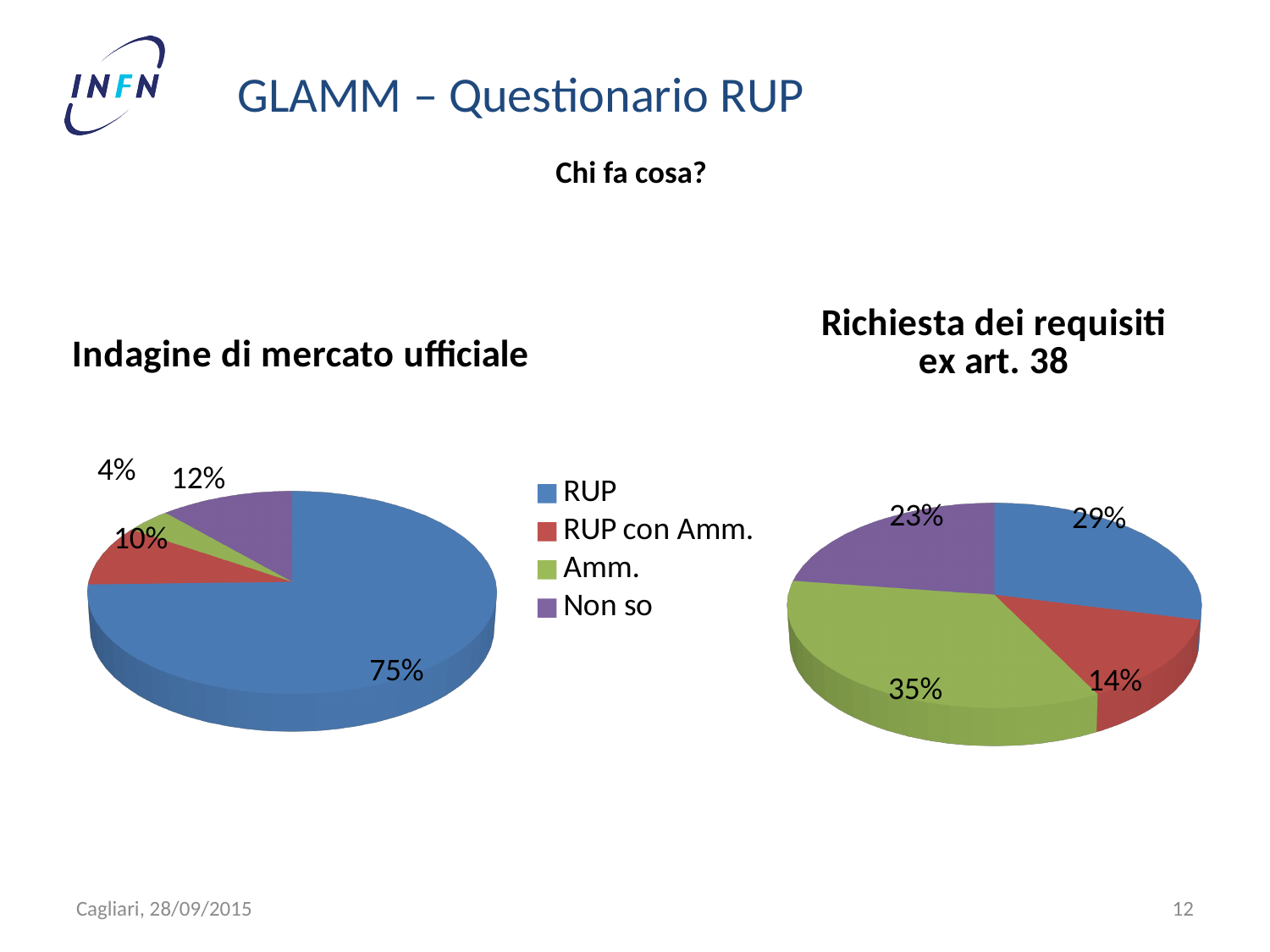
In the 'Richiesta dei requisiti ex art. 38' chart, what is the difference between the Amm. share and the RUP share? 6% Which colour represents Non so in the legend? Purple What type of chart is 'Indagine di mercato ufficiale'? Pie chart How many categories does the legend list for the pie charts? 4 In the 'Richiesta dei requisiti ex art. 38' chart, what share is labelled for Amm.? 35% In the 'Indagine di mercato ufficiale' chart, what share is labelled for Non so? 12% In the 'Richiesta dei requisiti ex art. 38' chart, which is larger, the RUP slice or the Non so slice? RUP In the 'Richiesta dei requisiti ex art. 38' chart, what share is labelled for RUP con Amm.? 14% In the 'Indagine di mercato ufficiale' chart, what share is labelled for RUP? 75% In the 'Indagine di mercato ufficiale' chart, what is the difference between the RUP share and the RUP con Amm. share? 65% In the 'Richiesta dei requisiti ex art. 38' chart, which category has the largest slice? Amm. In the 'Indagine di mercato ufficiale' chart, which category has the smallest slice? Amm.